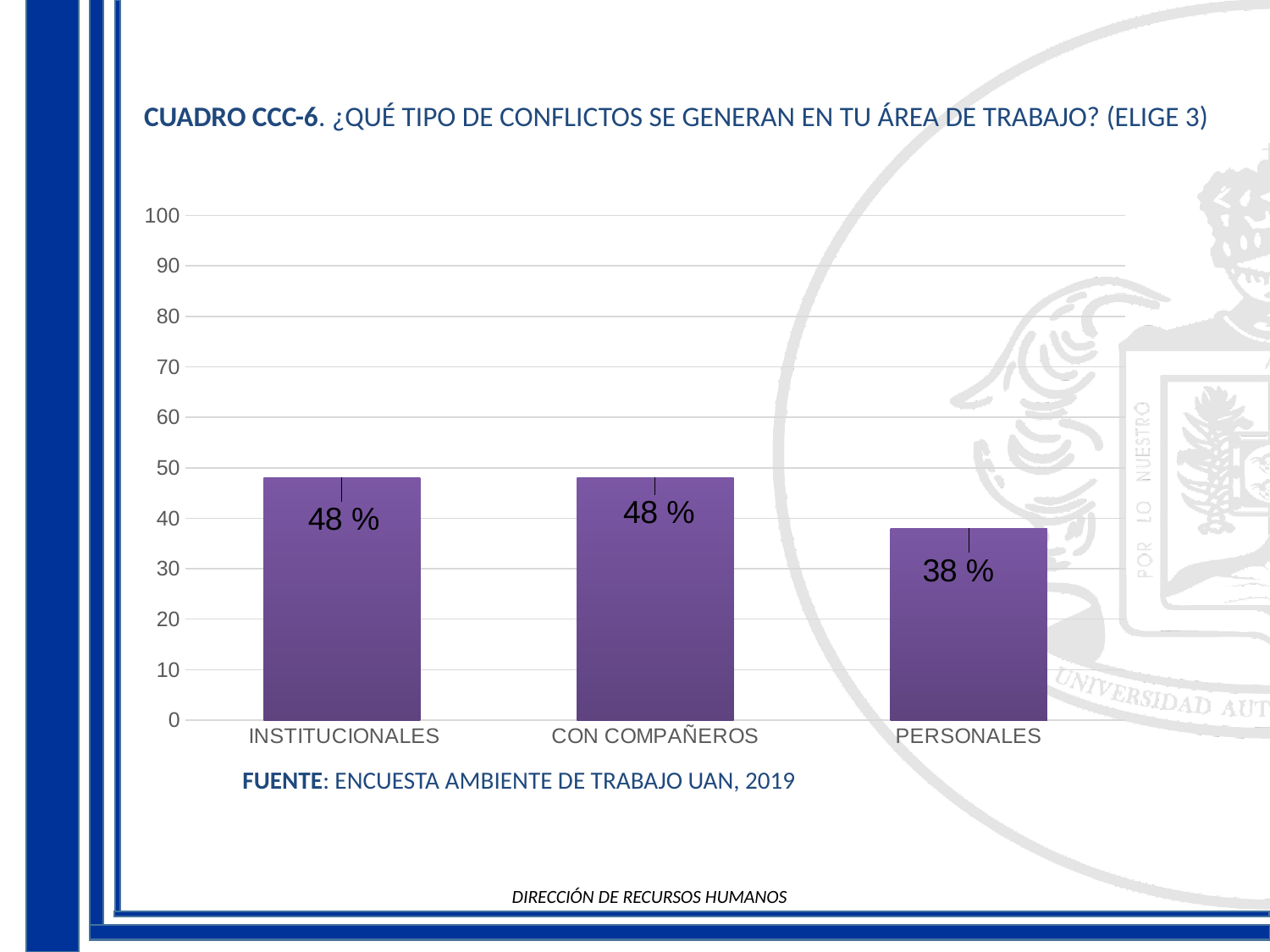
What is the value for PERSONALES? 38 % What is the source cited below the chart? ENCUESTA AMBIENTE DE TRABAJO UAN, 2019 What kind of chart is shown on the slide? bar chart Which category has the lowest value? PERSONALES Which is larger, the value for CON COMPAÑEROS or the value for PERSONALES? CON COMPAÑEROS What is the value for CON COMPAÑEROS? 48 % Is the value for PERSONALES greater or less than 40? less What is the value for INSTITUCIONALES? 48 % How many categories are shown on the x axis? 3 What is the difference between the values for INSTITUCIONALES and PERSONALES? 10 % What is the maximum value shown on the y axis? 100 Is the value for INSTITUCIONALES greater or less than 50? less